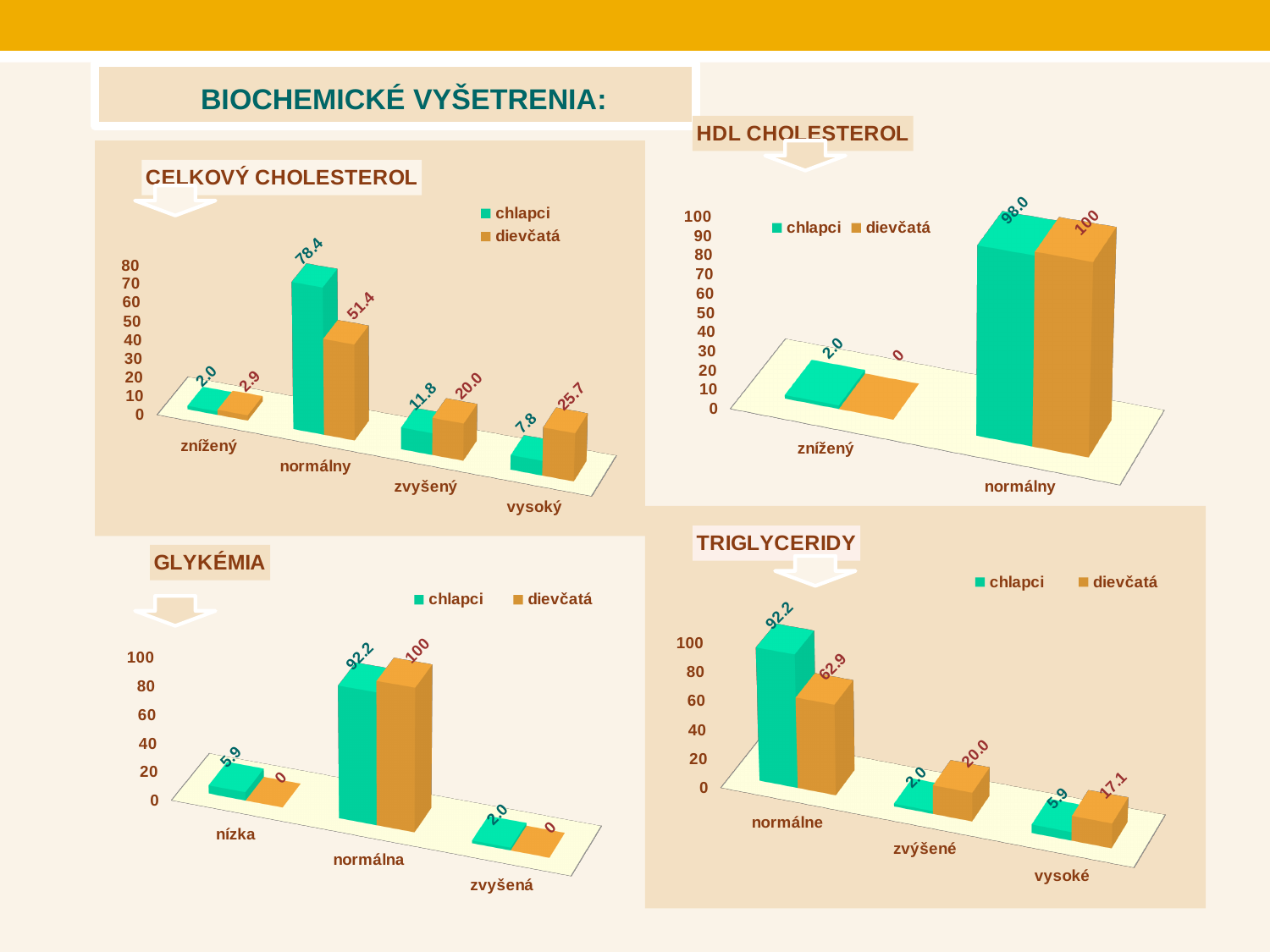
In the GLYKÉMIA chart, which is larger in the normálna category, chlapci or dievčatá? dievčatá In the CELKOVÝ CHOLESTEROL chart, how many categories are shown on the x axis? 4 In the HDL CHOLESTEROL chart, what is the value for dievčatá in the normálny category? 100 What kind of chart is the GLYKÉMIA chart? bar chart In the TRIGLYCERIDY chart, what is the value for dievčatá in the normálne category? 62.9 How many series does the legend of the TRIGLYCERIDY chart list? 2 In the TRIGLYCERIDY chart, what is the difference between dievčatá and chlapci in the zvýšené category? 18.0 In the CELKOVÝ CHOLESTEROL chart, what is the value for dievčatá in the vysoký category? 25.7 In the HDL CHOLESTEROL chart, which category has the lowest value for chlapci? znížený In the CELKOVÝ CHOLESTEROL chart, what is the value for chlapci in the normálny category? 78.4 In the GLYKÉMIA chart, what is the value for chlapci in the nízka category? 5.9 In the CELKOVÝ CHOLESTEROL chart, what is the difference between chlapci and dievčatá in the normálny category? 27.0